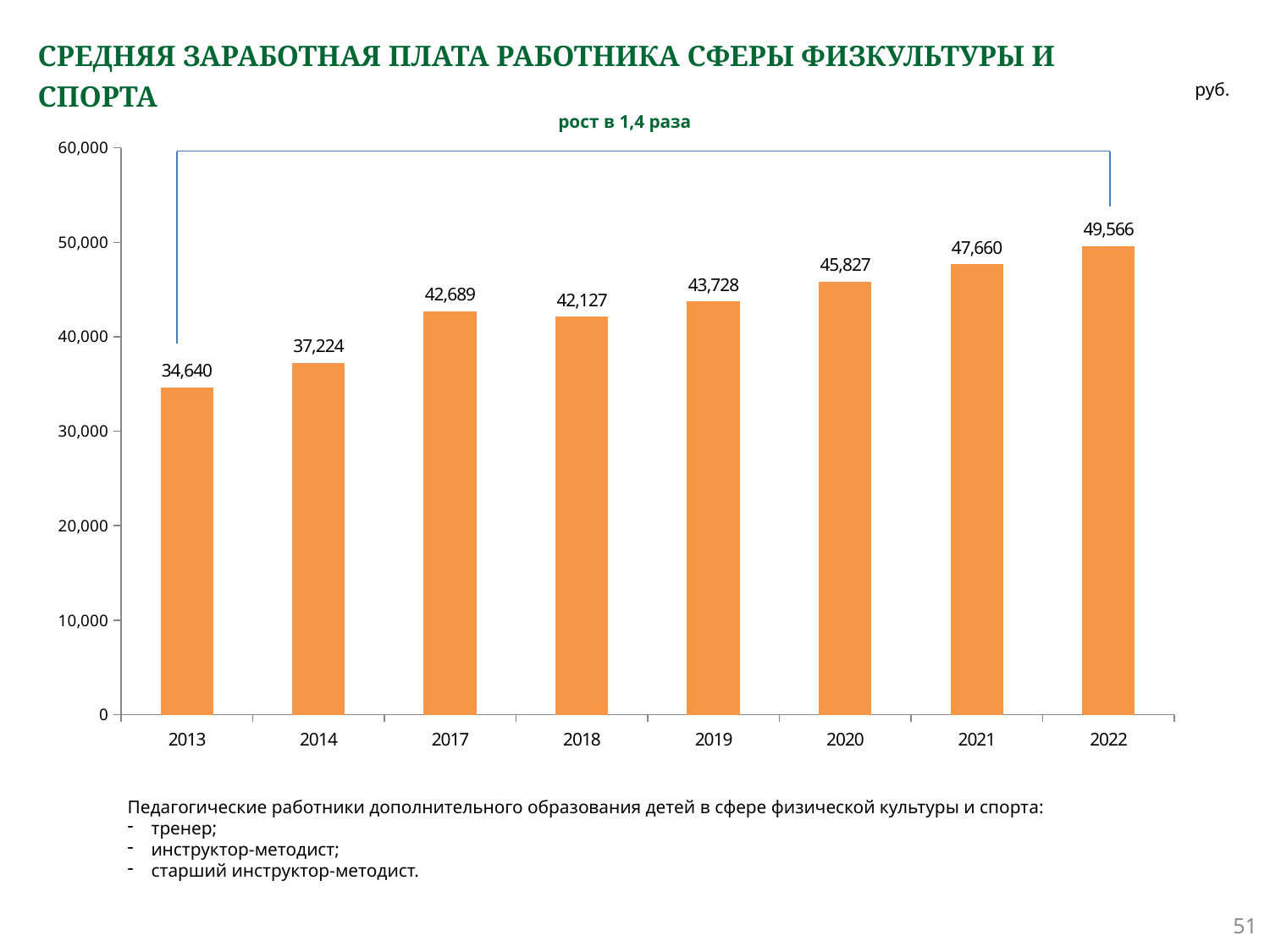
Which is larger, the value for 2017 or the value for 2018? 2017 What is the difference between the values for 2017 and 2018? 562 How many years are shown on the x axis? 8 Is the value for 2020 greater or less than 40,000? greater What is the difference between the values for 2022 and 2013? 14,926 What growth factor is stated in the annotation above the bars? рост в 1,4 раза What is the value shown for 2022? 49,566 What is the value shown for 2019? 43,728 What is the average salary value shown for 2013? 34,640 Which year has the lowest value? 2013 Which year has the highest value? 2022 What kind of chart is shown on the slide? bar chart